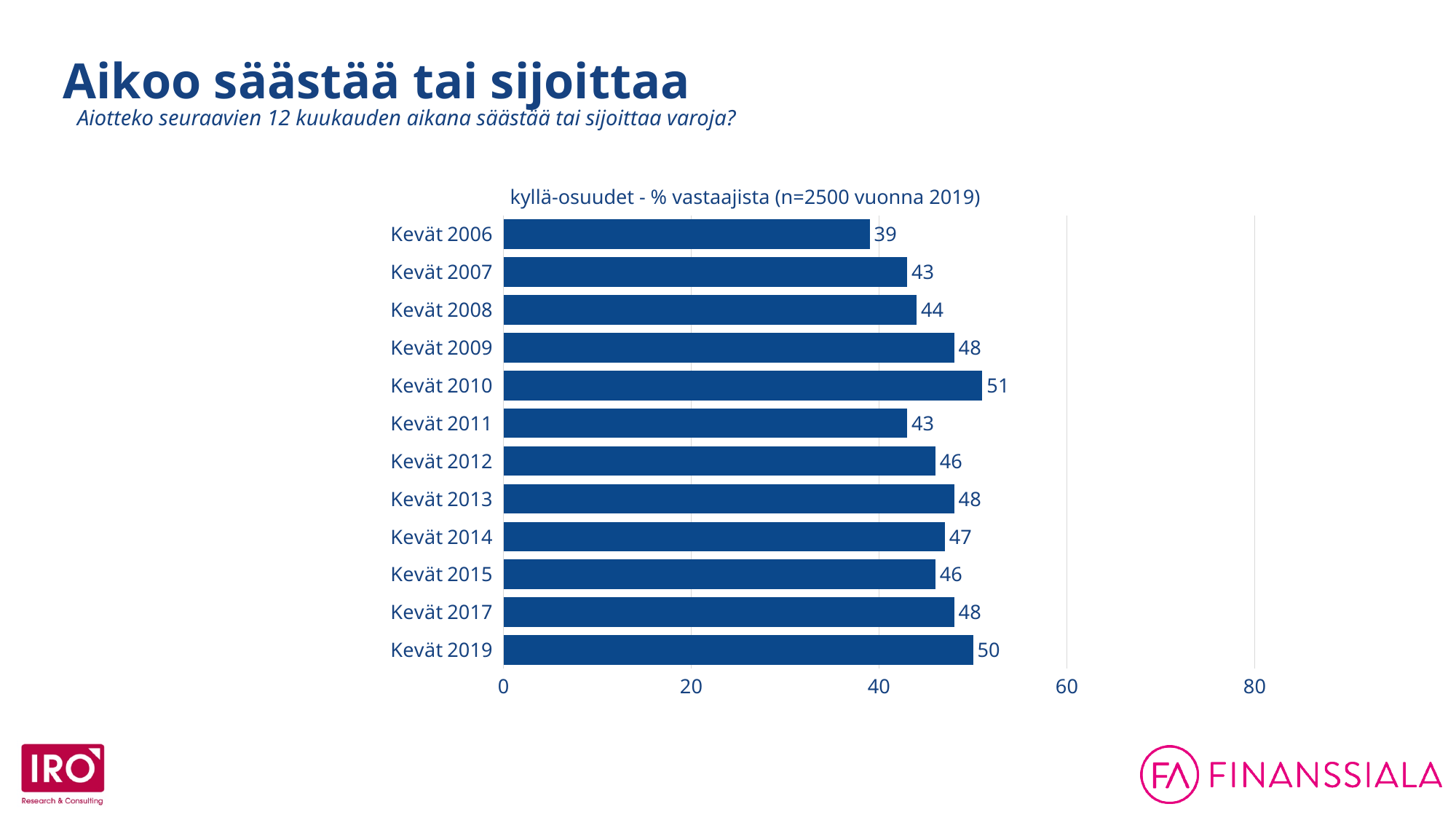
Is the value for Kevät 2014 greater or less than 40? greater What is the value for Kevät 2010? 51 How many categories are shown in the chart? 12 What is the difference between the values for Kevät 2010 and Kevät 2006? 12 What is the value for Kevät 2006? 39 What is the value for Kevät 2019? 50 What kind of chart is shown on the slide? bar chart Which is larger, the value for Kevät 2009 or the value for Kevät 2011? Kevät 2009 Which category has the highest value? Kevät 2010 What is the difference between the values for Kevät 2019 and Kevät 2017? 2 What is the title of the chart? kyllä-osuudet - % vastaajista (n=2500 vuonna 2019) Which category has the lowest value? Kevät 2006